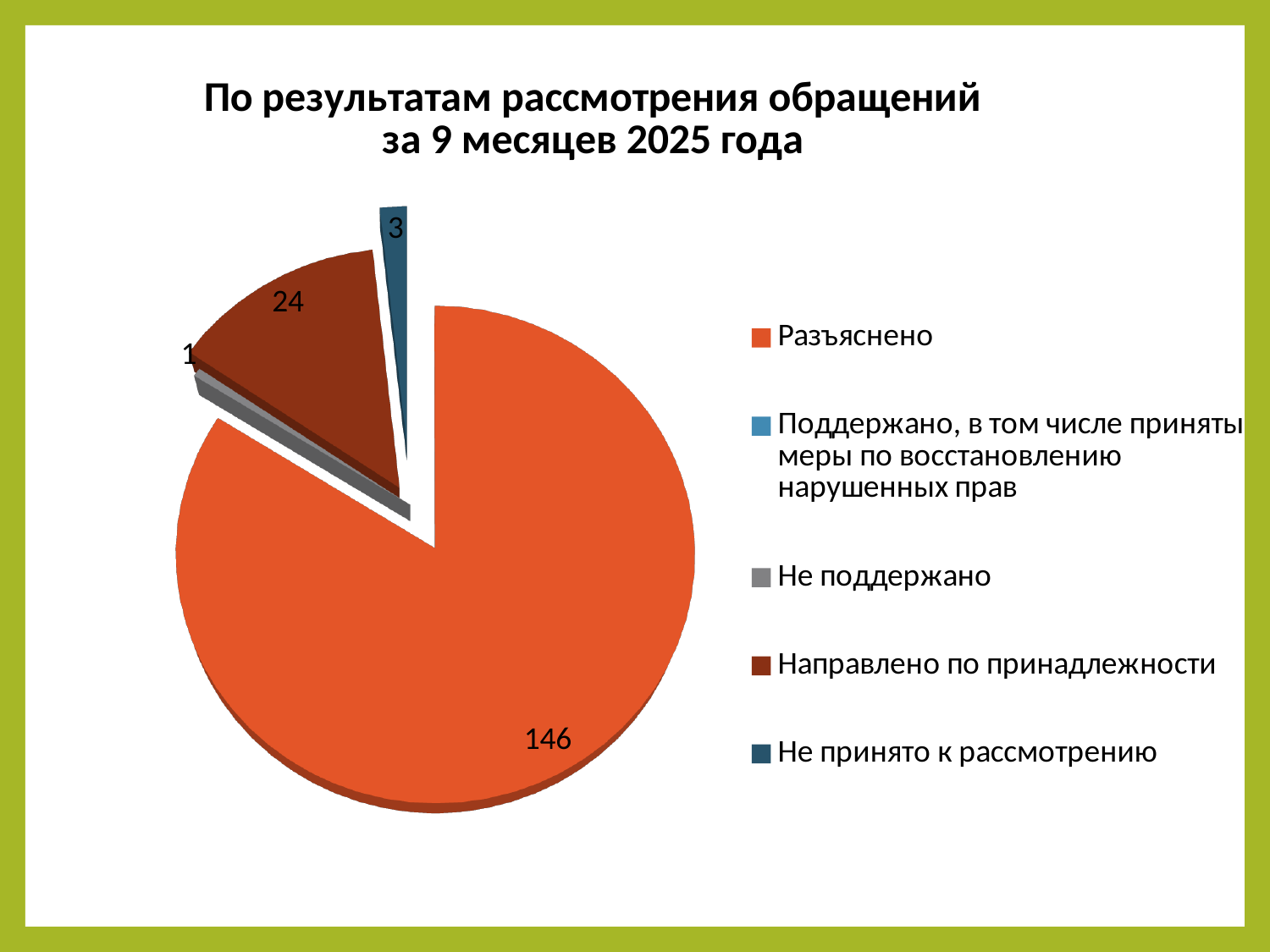
What is the title of the chart? По результатам рассмотрения обращений за 9 месяцев 2025 года What is the value for the "Разъяснено" slice? 146 What colour is the "Разъяснено" slice? orange What is the difference between the values for "Направлено по принадлежности" and "Не принято к рассмотрению"? 21 What is the value for the "Направлено по принадлежности" slice? 24 What is the value for the "Не принято к рассмотрению" slice? 3 What is the difference between the values for "Разъяснено" and "Направлено по принадлежности"? 122 What kind of chart is shown on the slide? pie chart Which is larger: the value for "Направлено по принадлежности" or the value for "Не принято к рассмотрению"? Направлено по принадлежности Which category has the largest slice of the pie? Разъяснено How many categories does the legend list? 5 What is the value for the "Не поддержано" slice? 1